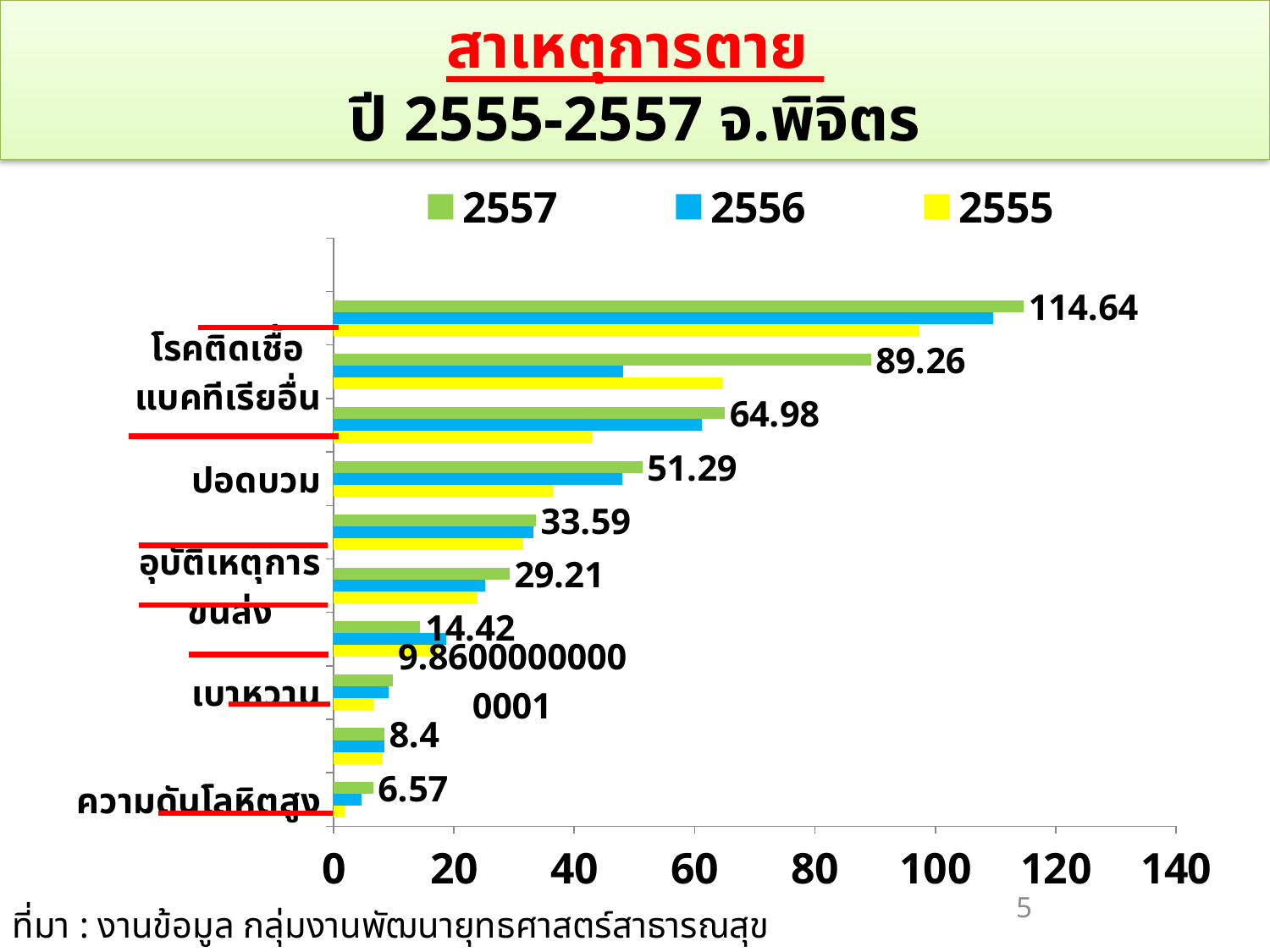
How many series does the legend list? 3 What is the highest labelled value in the chart? 114.64 What is the difference between the two largest labelled values, 114.64 and 89.26? 25.38 What kind of chart is shown on the slide? bar chart Which colour represents the 2556 series in the chart? blue Which is larger, the labelled value 33.59 or the labelled value 29.21? 33.59 Is the 2556 (blue) bar in the topmost group greater or less than 100? greater What is the lowest labelled value in the chart? 6.57 Is the 2555 (yellow) bar in the topmost group greater or less than 100? less Which years are listed in the chart legend? 2557, 2556, 2555 How many groups of bars are plotted in the chart? 10 Do the labelled 2557 values rise or fall moving from the top of the chart to the bottom? fall